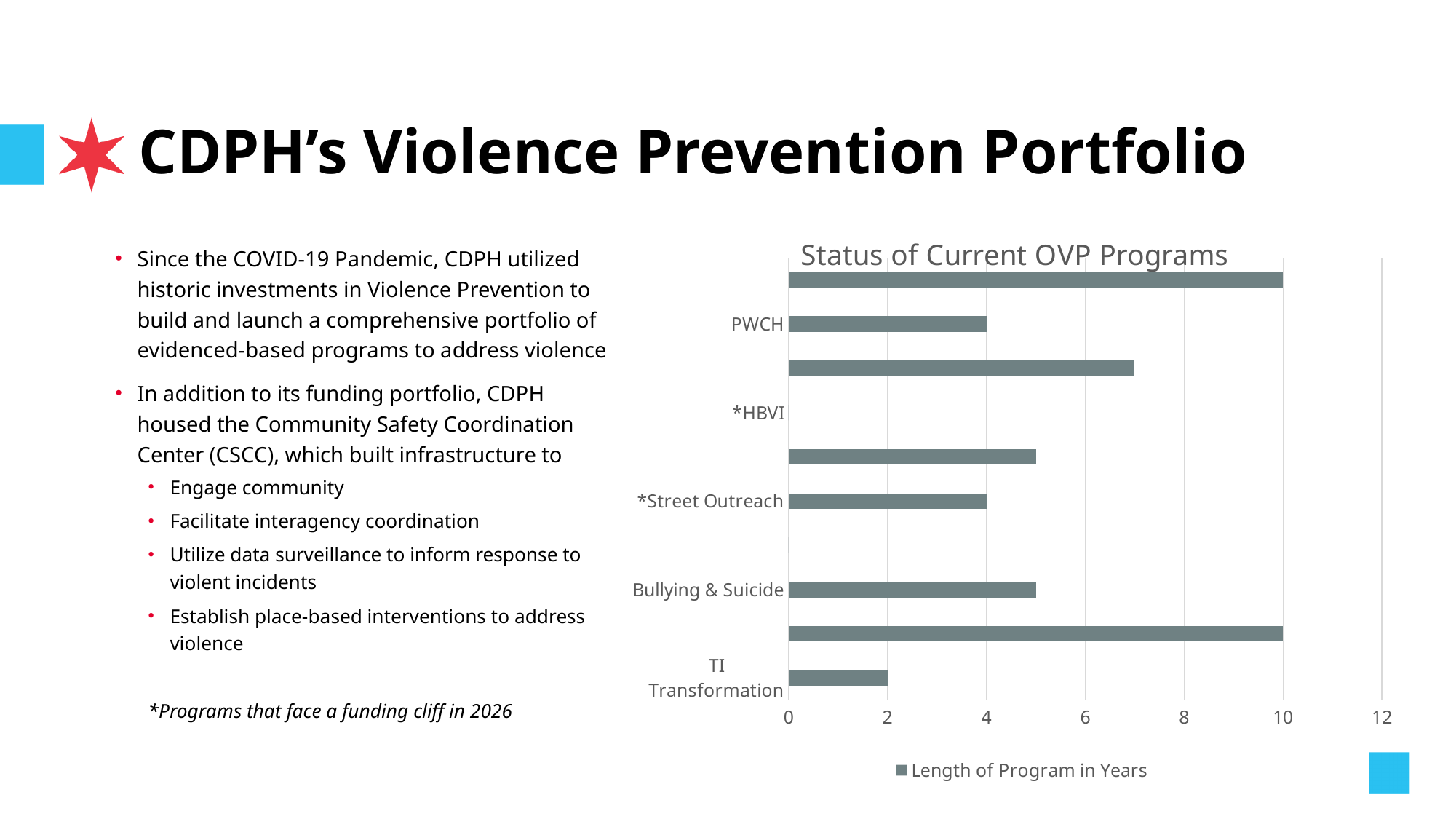
Which has a longer program length, PWCH or TI Transformation? PWCH What is the difference in program length between PWCH and TI Transformation? 2 Is the value for Bullying & Suicide greater or less than 4? greater What is the length of program in years for PWCH? 4 Which has a longer program length, Bullying & Suicide or *Street Outreach? Bullying & Suicide What is the legend entry of the chart? Length of Program in Years What is the title of the chart? Status of Current OVP Programs What is the length of program in years for TI Transformation? 2 How many series does the chart legend list? 1 What kind of chart is shown on the slide? bar chart What is the length of program in years for *Street Outreach? 4 Is the value for TI Transformation greater or less than 4? less